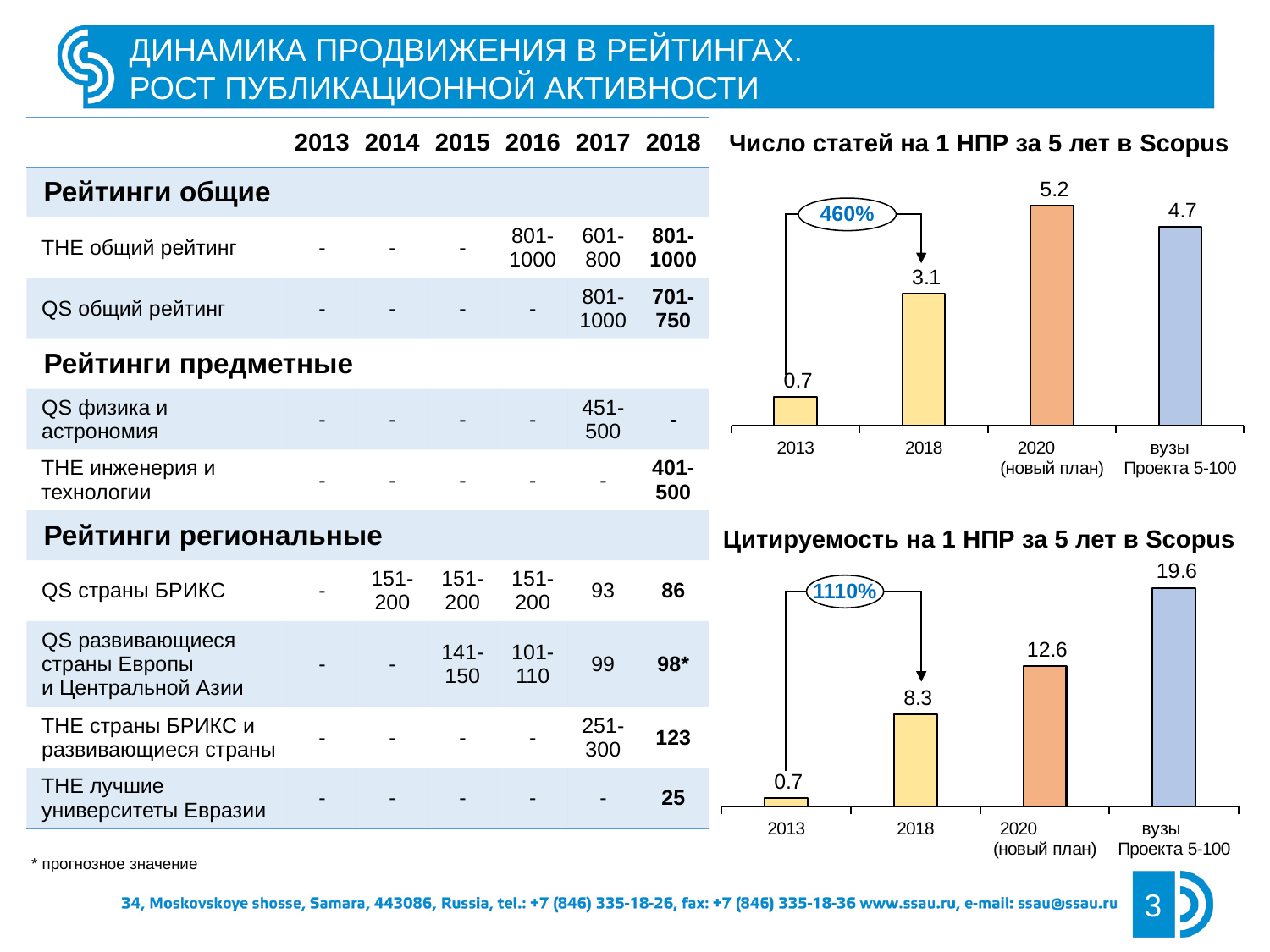
In the chart 'Число статей на 1 НПР за 5 лет в Scopus', what is the value for 2020 (новый план)? 5.2 In the chart 'Число статей на 1 НПР за 5 лет в Scopus', which is larger: the value for 2020 (новый план) or for вузы Проекта 5-100? 2020 (новый план) In the chart 'Число статей на 1 НПР за 5 лет в Scopus', what is the value for 2018? 3.1 In the chart 'Число статей на 1 НПР за 5 лет в Scopus', what is the difference between the values for 2018 and 2013? 2.4 In the chart 'Число статей на 1 НПР за 5 лет в Scopus', which category has the highest value? 2020 (новый план) In the chart 'Цитируемость на 1 НПР за 5 лет в Scopus', what is the value for 2018? 8.3 In the chart 'Цитируемость на 1 НПР за 5 лет в Scopus', what is the difference between the values for 2020 (новый план) and 2018? 4.3 In the chart 'Цитируемость на 1 НПР за 5 лет в Scopus', what percentage growth is shown in the callout between 2013 and 2018? 1110% How many bars are shown in the chart 'Число статей на 1 НПР за 5 лет в Scopus'? 4 In the chart 'Цитируемость на 1 НПР за 5 лет в Scopus', which category has the lowest value? 2013 In the chart 'Цитируемость на 1 НПР за 5 лет в Scopus', what is the value for вузы Проекта 5-100? 19.6 What type of chart is 'Цитируемость на 1 НПР за 5 лет в Scopus'? Bar chart